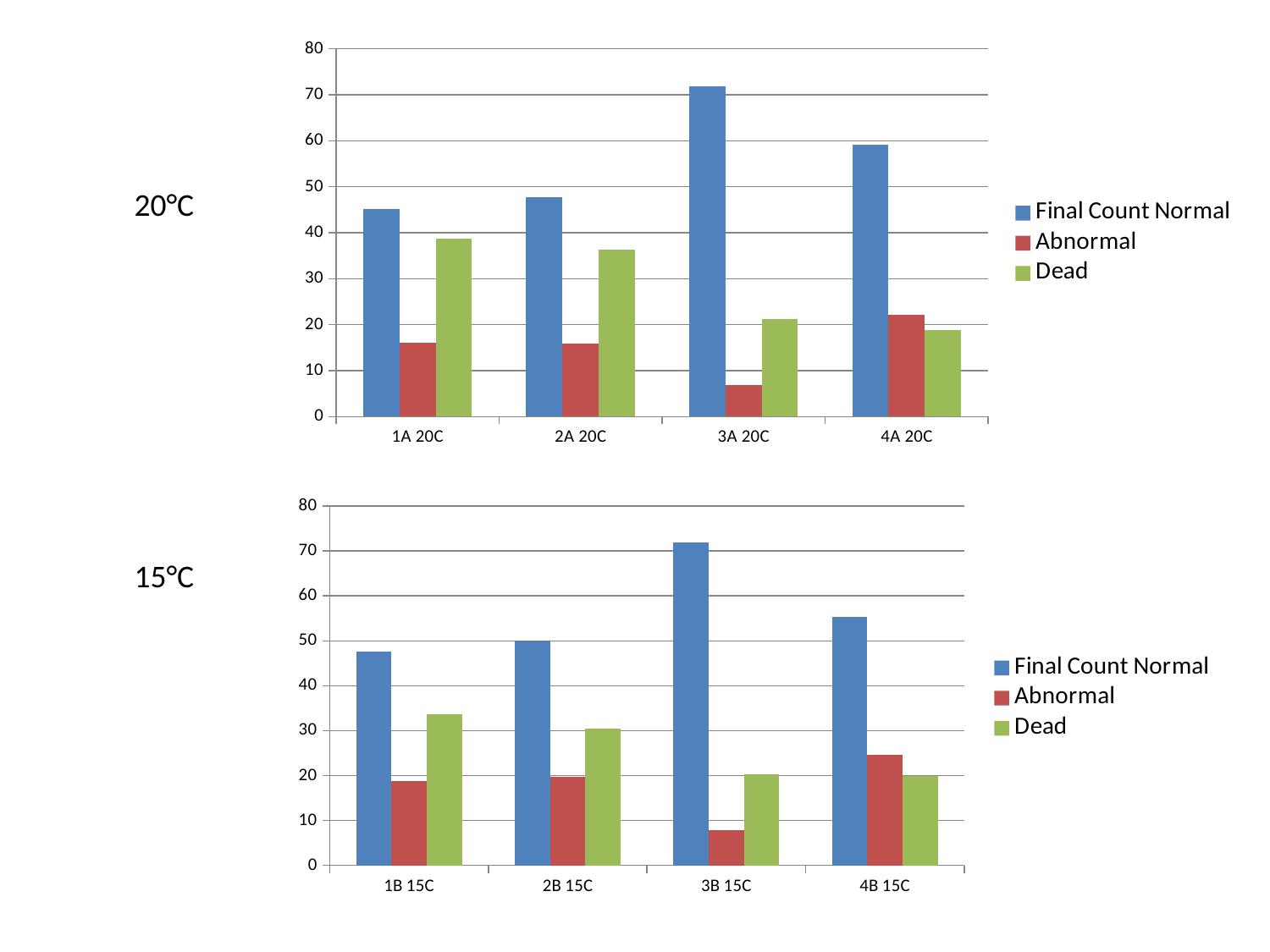
In the top chart (20°C), which category has the highest Final Count Normal value? 3A 20C In the top chart (20°C), is the Dead value for 1A 20C greater or less than 30? greater What temperature label appears to the left of the bottom chart? 15°C How many categories are shown on the x axis of the bottom chart (15°C)? 4 In the bottom chart (15°C), is the Abnormal value for 3B 15C greater or less than 10? less What kind of chart is the top chart (20°C)? bar chart In the bottom chart (15°C), which category has the highest Final Count Normal value? 3B 15C In the top chart (20°C), is the Final Count Normal value for 3A 20C greater or less than 60? greater In the top chart (20°C), for 1A 20C, which is larger: the Abnormal value or the Dead value? Dead How many series does the legend of the top chart (20°C) list? 3 In the bottom chart (15°C), for 4B 15C, which is larger: the Abnormal value or the Dead value? Abnormal In the top chart (20°C), which category has the lowest Abnormal value? 3A 20C